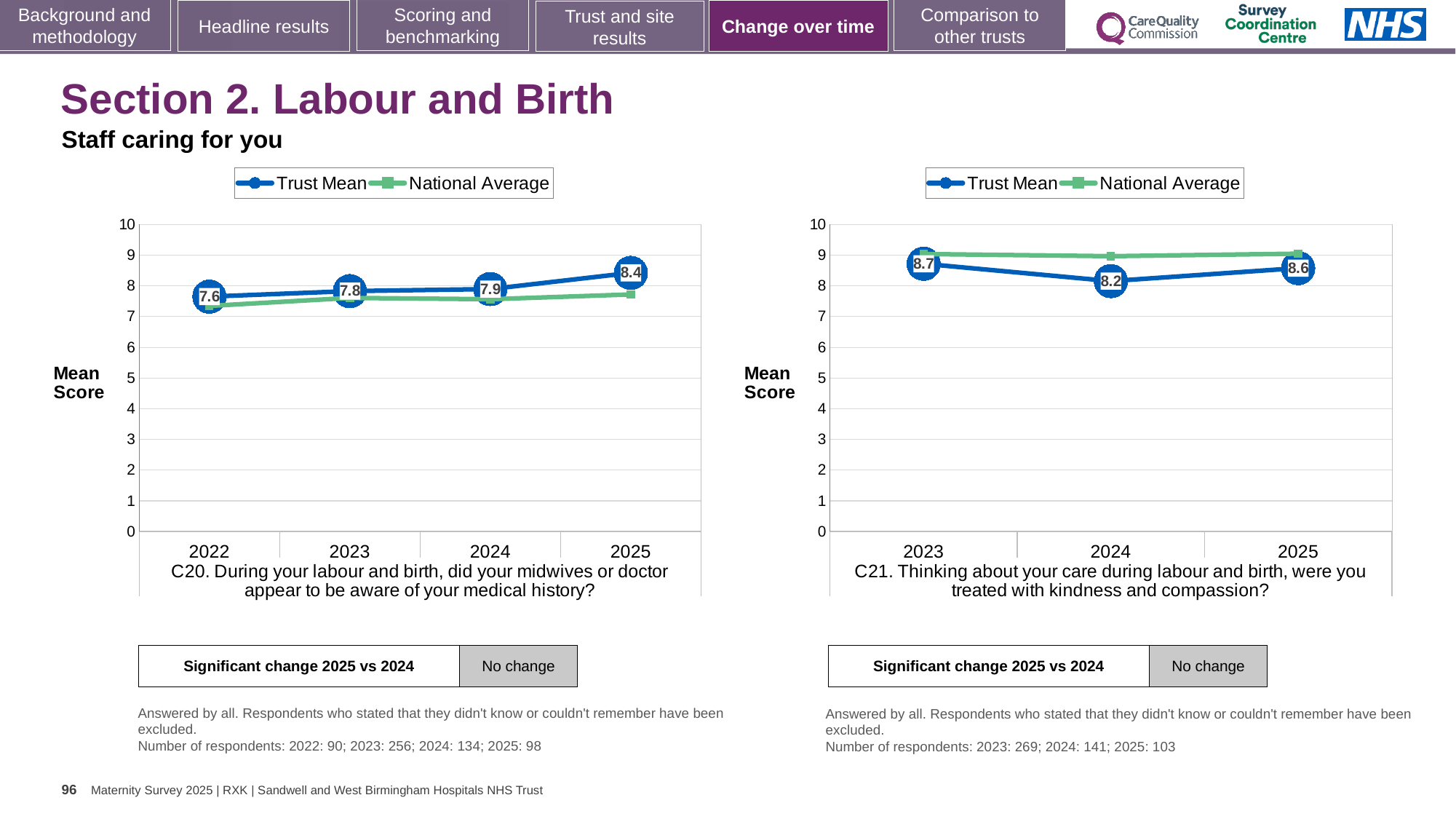
In the C21 chart (right), what is the Trust Mean for 2024? 8.2 In the C20 chart (left), which year has the lowest Trust Mean? 2022 What kind of chart is the C20 chart (left)? line chart In the C20 chart (left), what is the Trust Mean for 2022? 7.6 How many years are shown on the x axis of the C20 chart (left)? 4 In the C21 chart (right), is the Trust Mean for 2025 higher or lower than for 2024? higher In the C21 chart (right), what is the difference between the Trust Mean for 2023 and 2024? 0.5 In the C20 chart (left), what is the Trust Mean for 2025? 8.4 How many series does the legend of the C21 chart (right) list? 2 In the C20 chart (left), is the National Average for 2025 greater or less than 7? greater In the C21 chart (right), which year has the highest Trust Mean? 2023 In the C20 chart (left), what is the difference between the Trust Mean for 2025 and 2024? 0.5